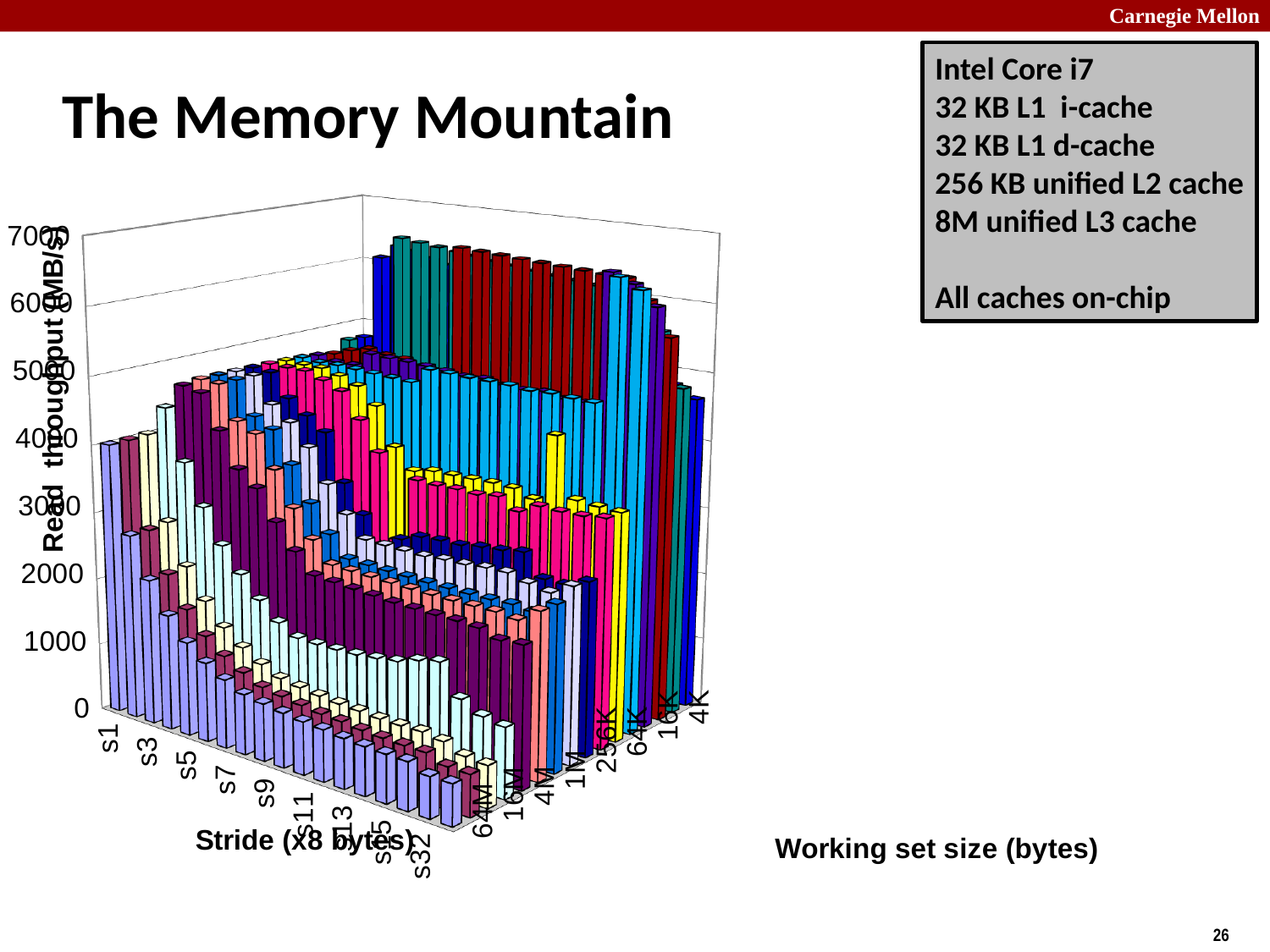
What kind of chart is shown on the slide? 3D bar chart Is the read throughput for stride s1 at working set size 4K greater or less than 6000? less What is the label of the stride axis of the chart? Stride (x8 bytes) Which working set size label is at the far end of the working set axis, next to 16K? 4K For a working set size of 64M, does read throughput rise or fall as the stride increases from s1 to s32? fall Which stride label is the last one shown on the stride axis? s32 For stride s1, is read throughput higher at working set size 4K or at 64M? 4K How many working set size labels are shown along the working set axis? 8 What is the label of the vertical axis of the chart? Read throughput (MB/s) What is the highest tick value shown on the vertical axis? 7000 Is the read throughput for stride s32 at working set size 64M greater or less than 1000? less How many stride labels are shown along the stride axis? 9